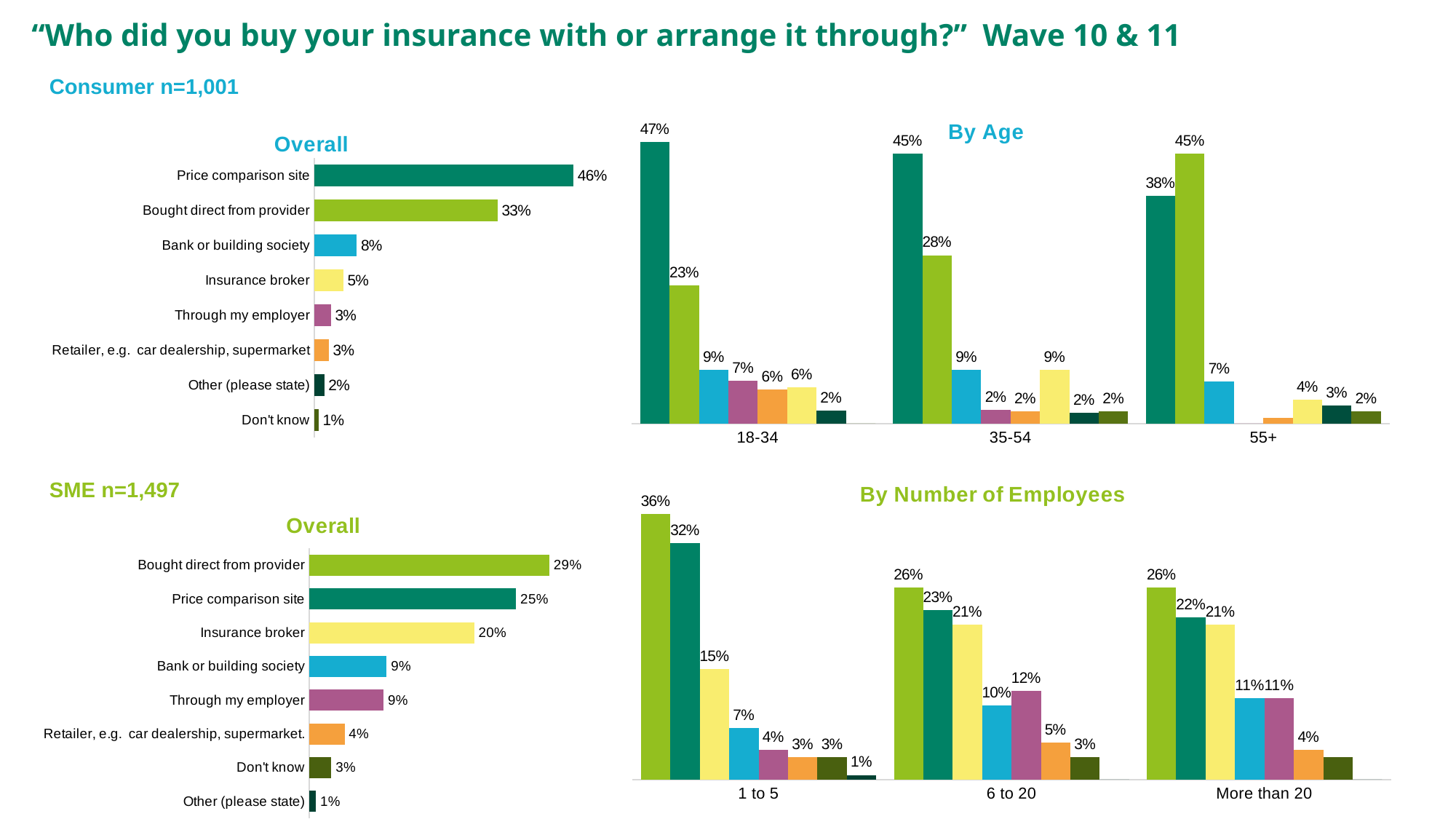
In the Consumer Overall chart, which category has the lowest value? Don't know In the SME Overall chart, which is larger: Bank or building society or Retailer, e.g. car dealership, supermarket? Bank or building society In the By Number of Employees chart, what is the value of the tallest bar in the 1 to 5 group? 36% In the SME Overall chart, which category has the highest value? Bought direct from provider In the Consumer Overall chart, which category has the highest value? Price comparison site What type of chart is the Consumer Overall chart? Bar chart In the SME Overall chart, what percentage is shown for Insurance broker? 20% In the By Age chart, what is the value of the tallest bar in the 18-34 group? 47% In the SME Overall chart, how many categories are plotted? 8 In the Consumer Overall chart, what percentage is shown for Price comparison site? 46% In the Consumer Overall chart, what is the difference between Price comparison site and Bought direct from provider? 13 percentage points In the By Age chart, how many age groups are shown on the x axis? 3